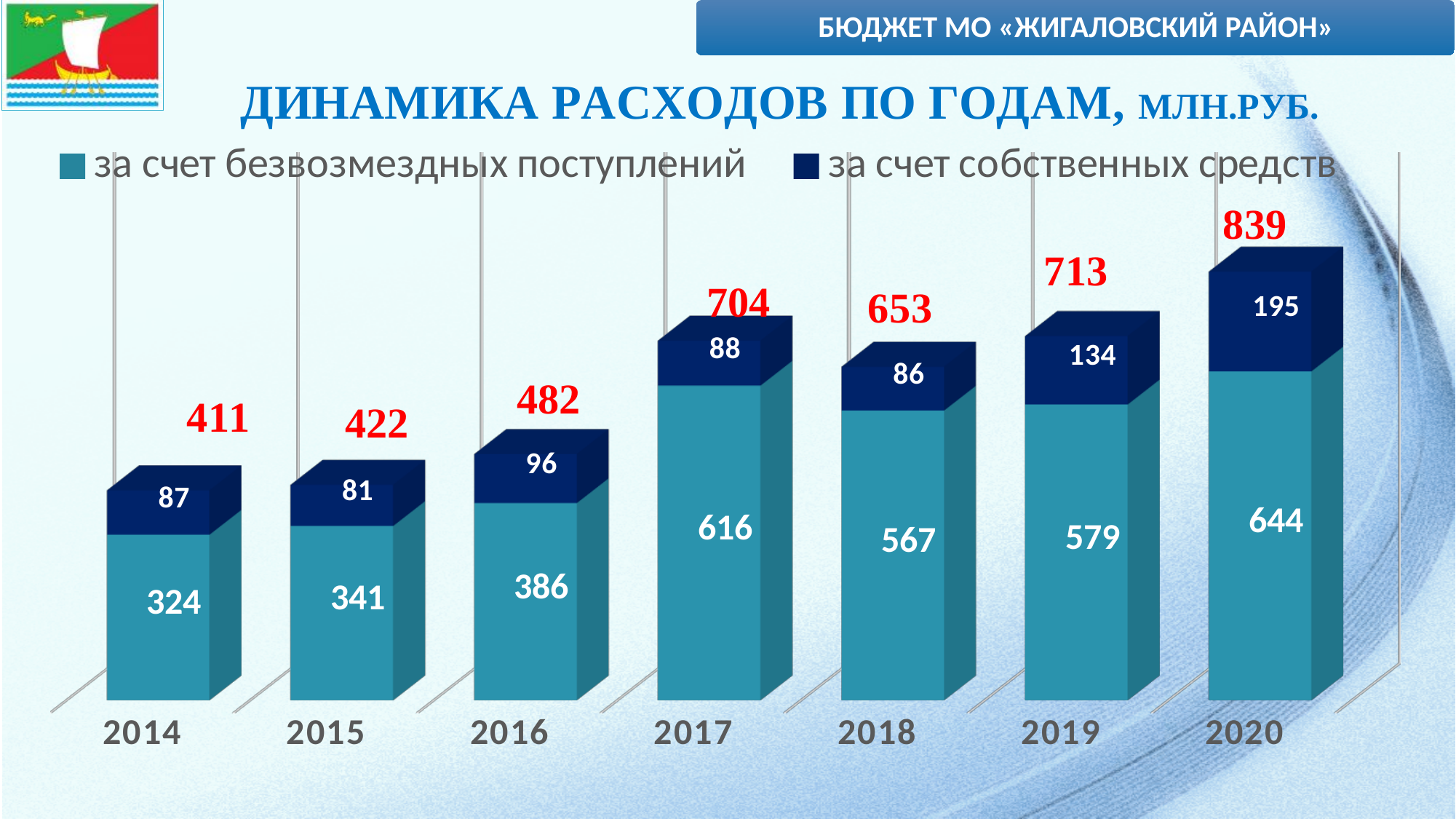
How many years are shown on the x axis? 7 What is the difference between the "за счет собственных средств" values for 2019 and 2018? 48 What is the value for "за счет собственных средств" in 2020? 195 Which year has the lowest total expenditure? 2014 Which is larger: the "за счет безвозмездных поступлений" value for 2017 or for 2018? 2017 How many series does the legend list? 2 What is the difference between the totals for 2020 and 2019? 126 What is the value for "за счет безвозмездных поступлений" in 2017? 616 Which year has the highest total expenditure? 2020 What kind of chart is shown on the slide? Stacked bar chart What is the total shown above the stacked bar for 2018? 653 What is the title of the chart? ДИНАМИКА РАСХОДОВ ПО ГОДАМ, МЛН.РУБ.